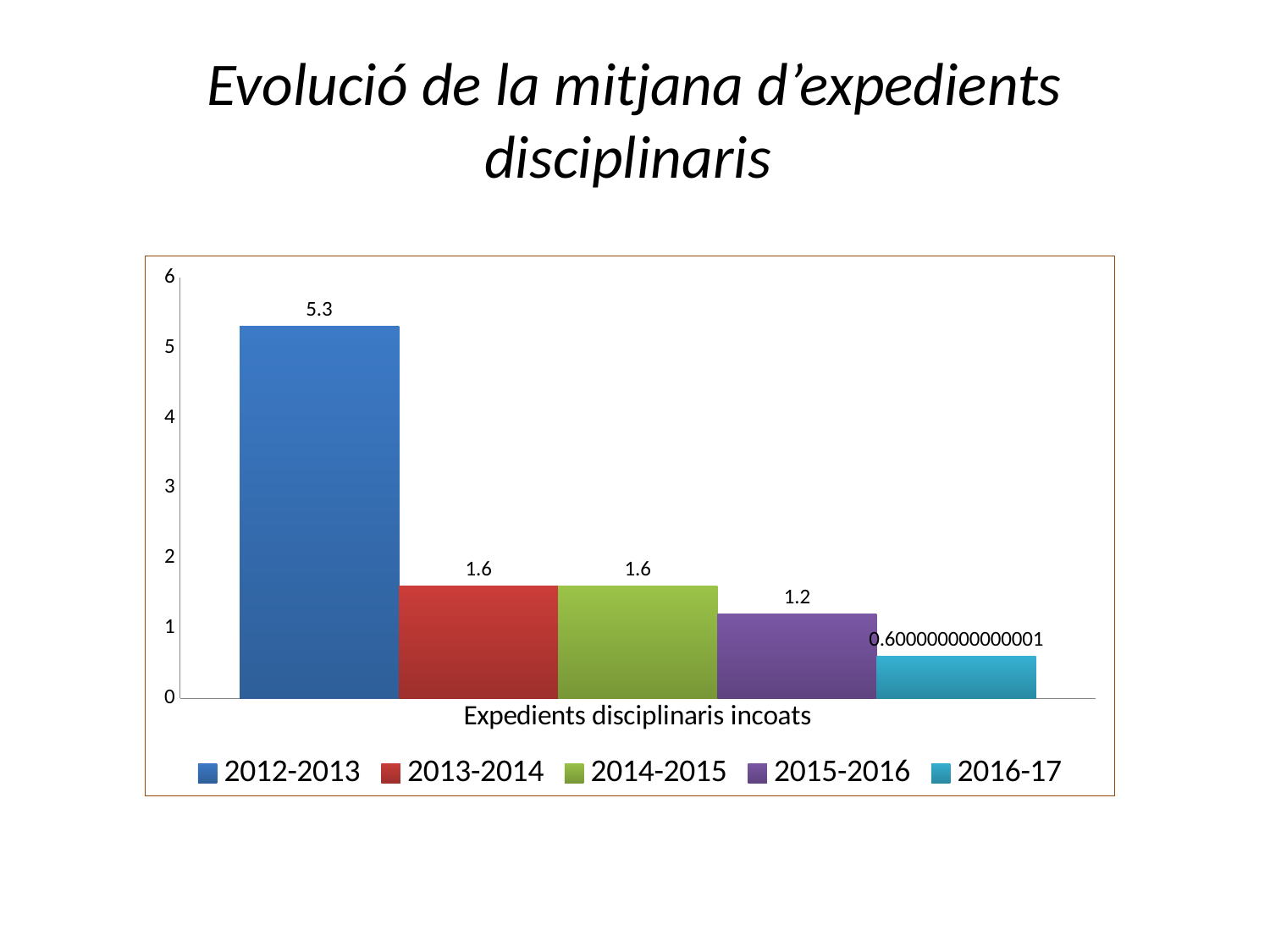
What is the difference between the values for 2014-2015 and 2015-2016? 0.4 Which series has the highest value? 2012-2013 What is the category label shown on the x axis? Expedients disciplinaris incoats What is the value for 2012-2013? 5.3 How many series does the legend list? 5 Which series has the lowest value? 2016-17 What is the value for 2013-2014? 1.6 What is the difference between the values for 2012-2013 and 2013-2014? 3.7 What value is printed on the 2016-17 bar? 0.600000000000001 What is the value for 2015-2016? 1.2 What kind of chart is shown on the slide? Bar chart Which is larger, the value for 2015-2016 or the value for 2016-17? 2015-2016